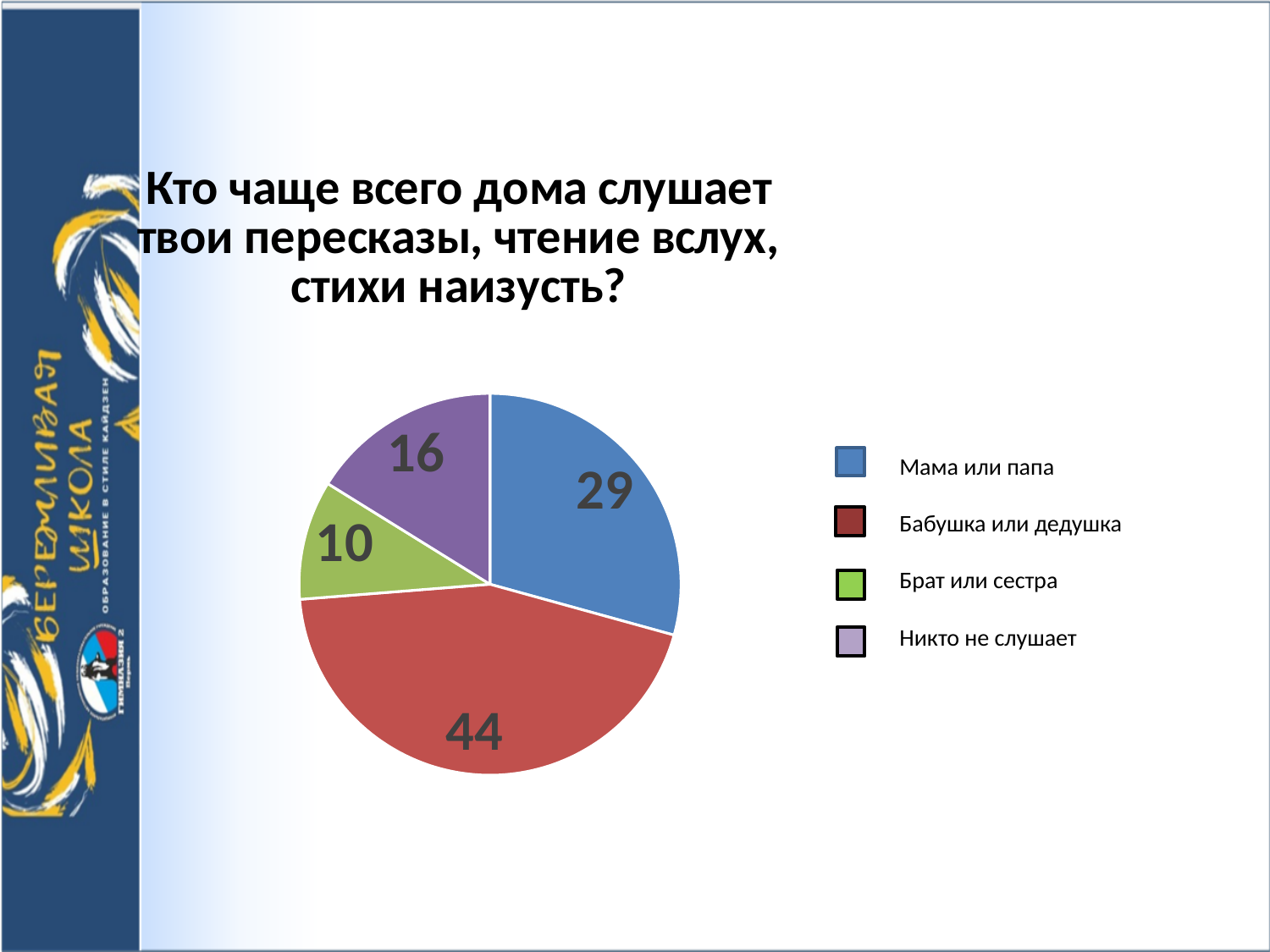
What is the difference between the values for "Бабушка или дедушка" and "Мама или папа"? 15 Which category has the smallest slice of the pie? Брат или сестра What is the value for "Бабушка или дедушка"? 44 What type of chart is shown on the slide? pie chart Which is larger: the value for "Никто не слушает" or the value for "Брат или сестра"? Никто не слушает What is the value for "Никто не слушает"? 16 What is the value for "Мама или папа"? 29 How many categories does the pie chart have? 4 Which category has the largest slice of the pie? Бабушка или дедушка What is the value for "Брат или сестра"? 10 What colour is the slice for "Никто не слушает"? purple What is the total of all the values shown in the pie chart? 99